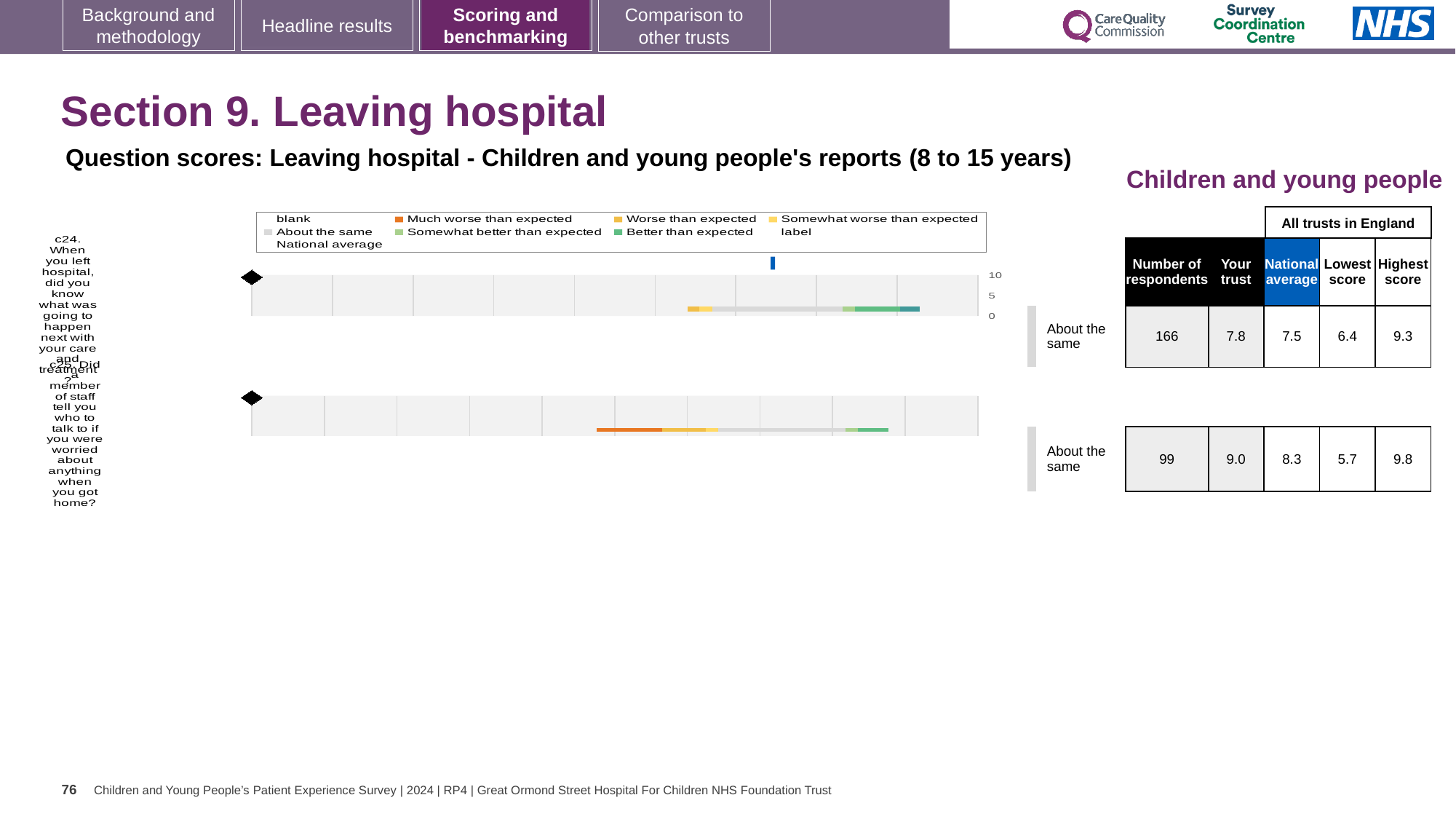
What is the highest score among all trusts in England for question c25? 9.8 Is the trust's score for question c24 greater or less than 5? greater By how much does the trust's score for c25 exceed the national average for c25? 0.7 What is the 'Your trust' score for question c24 (When you left hospital, did you know what was going to happen next with your care and treatment?)? 7.8 How many respondents answered question c24? 166 What benchmarking category is shown for question c25? About the same How many survey questions are plotted on the slide? 2 What is the difference between the highest and lowest trust scores for question c24? 2.9 What is the lowest score among all trusts in England for question c24? 6.4 What kind of chart is used to show the question scores for c24 and c25? bar chart What is the national average score for question c25 (Did a member of staff tell you who to talk to if you were worried about anything when you got home?)? 8.3 Which question has the higher 'Your trust' score, c24 or c25? c25